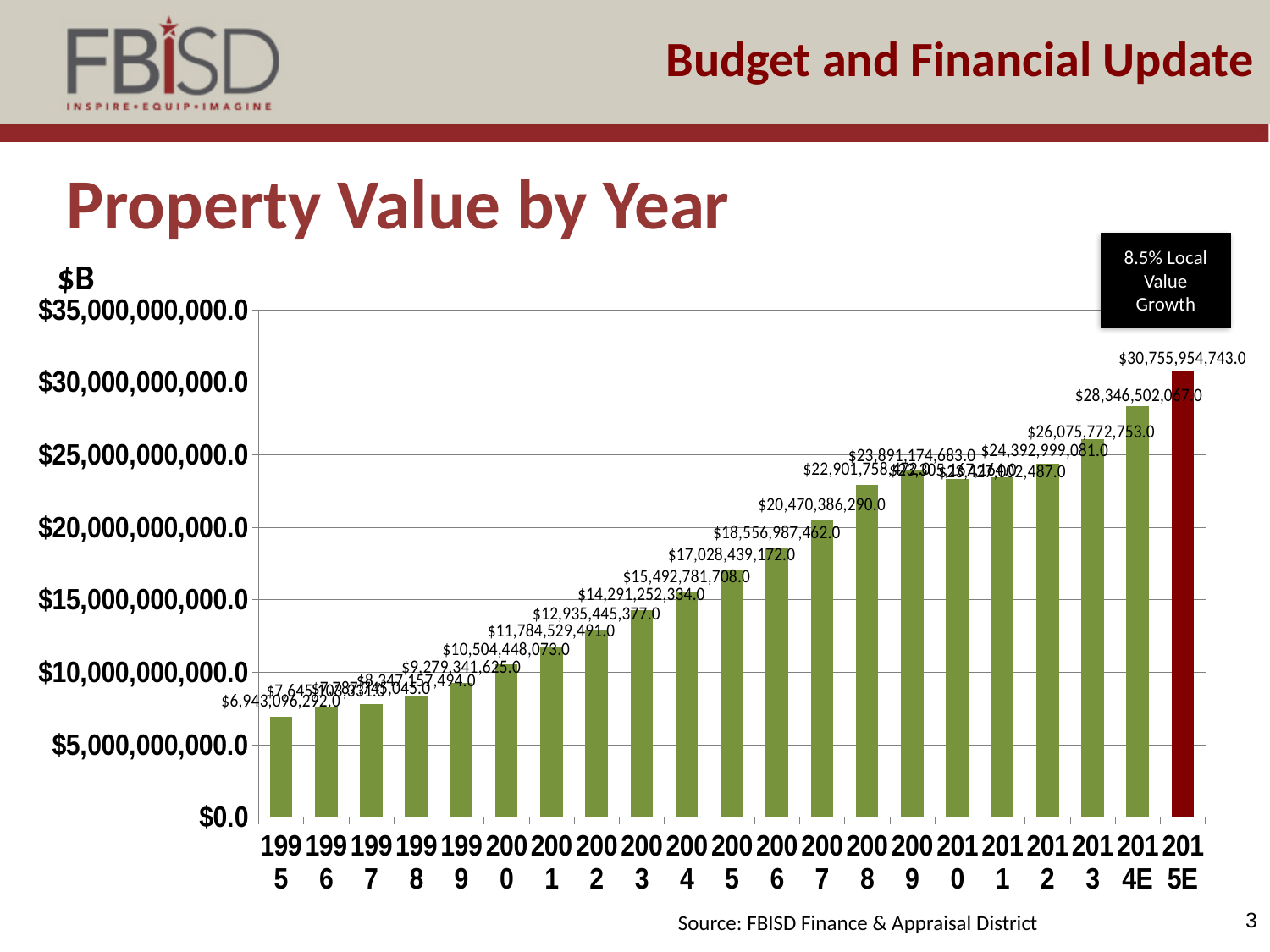
Which year has the highest property value in the chart? 2015E What is the difference between the property values for 2015E and 2014E? $2,409,452,676.0 What type of chart is shown on the slide? Bar chart Is the property value for 1998 greater or less than $10,000,000,000.0? less What is the property value shown for 2007? $20,470,386,290.0 What is the property value shown for 1995? $6,943,096,292.0 What is the property value shown for 2014E? $28,346,502,067.0 What is the property value shown for 2015E? $30,755,954,743.0 How many years (bars) are plotted in the Property Value by Year chart? 21 What local value growth percentage is noted in the box at the top right of the chart? 8.5% Do property values generally rise or fall from 1995 to 2015E? Rise Which year has the lowest property value in the chart? 1995